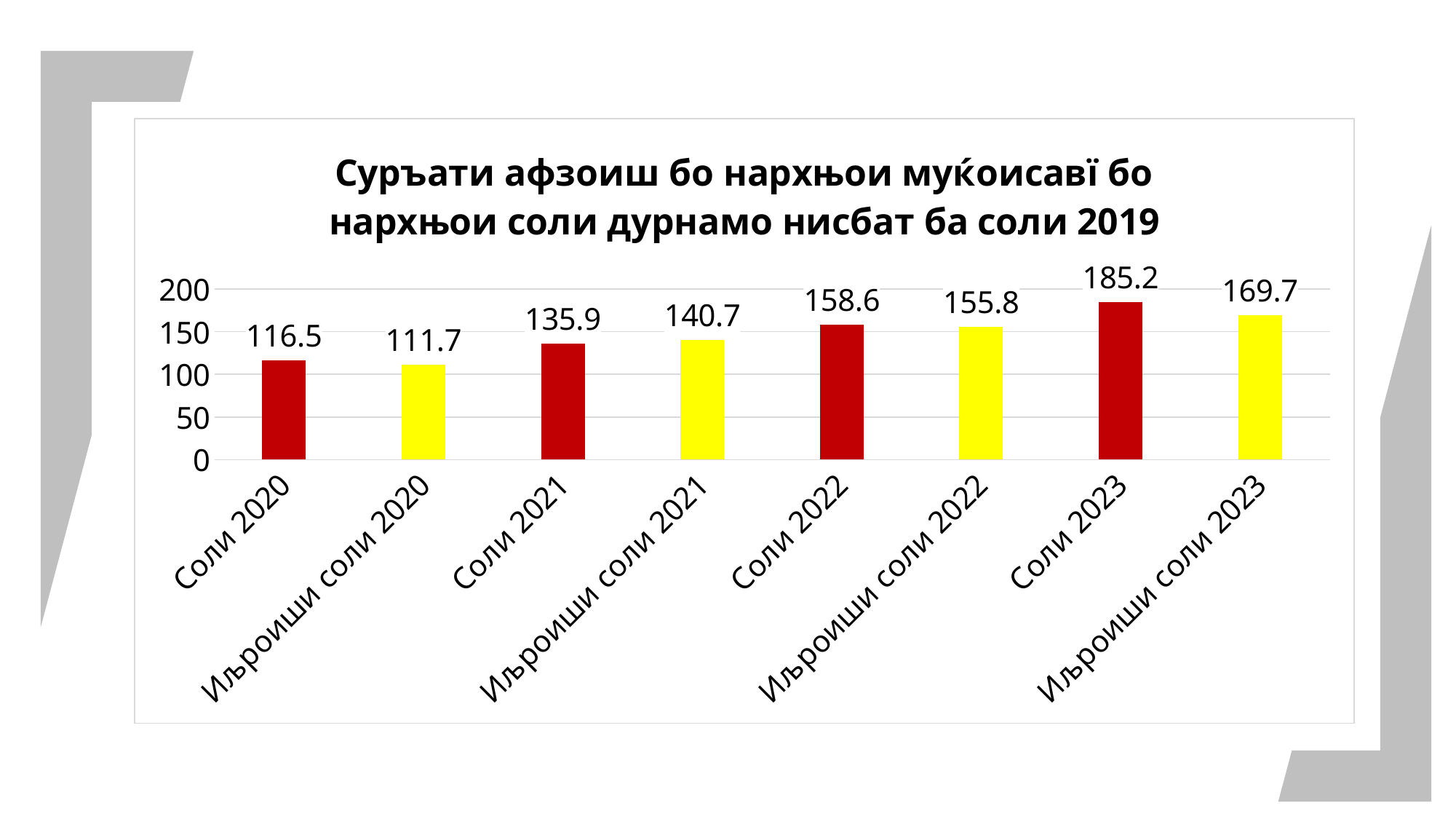
Do the values for the Соли categories rise or fall from 2020 to 2023? rise Which category has the lowest value? Иљроиши соли 2020 What is the value for Иљроиши соли 2022? 155.8 What is the difference between the values for Соли 2023 and Иљроиши соли 2023? 15.5 Which category has the highest value? Соли 2023 Which is larger, the value for Соли 2022 or the value for Иљроиши соли 2022? Соли 2022 What kind of chart is shown on the slide? bar chart Is the value for Иљроиши соли 2021 greater or less than 150? less What is the difference between the values for Соли 2021 and Соли 2020? 19.4 How many bars are shown in the chart? 8 What is the value for Соли 2020? 116.5 What is the value for Соли 2023? 185.2